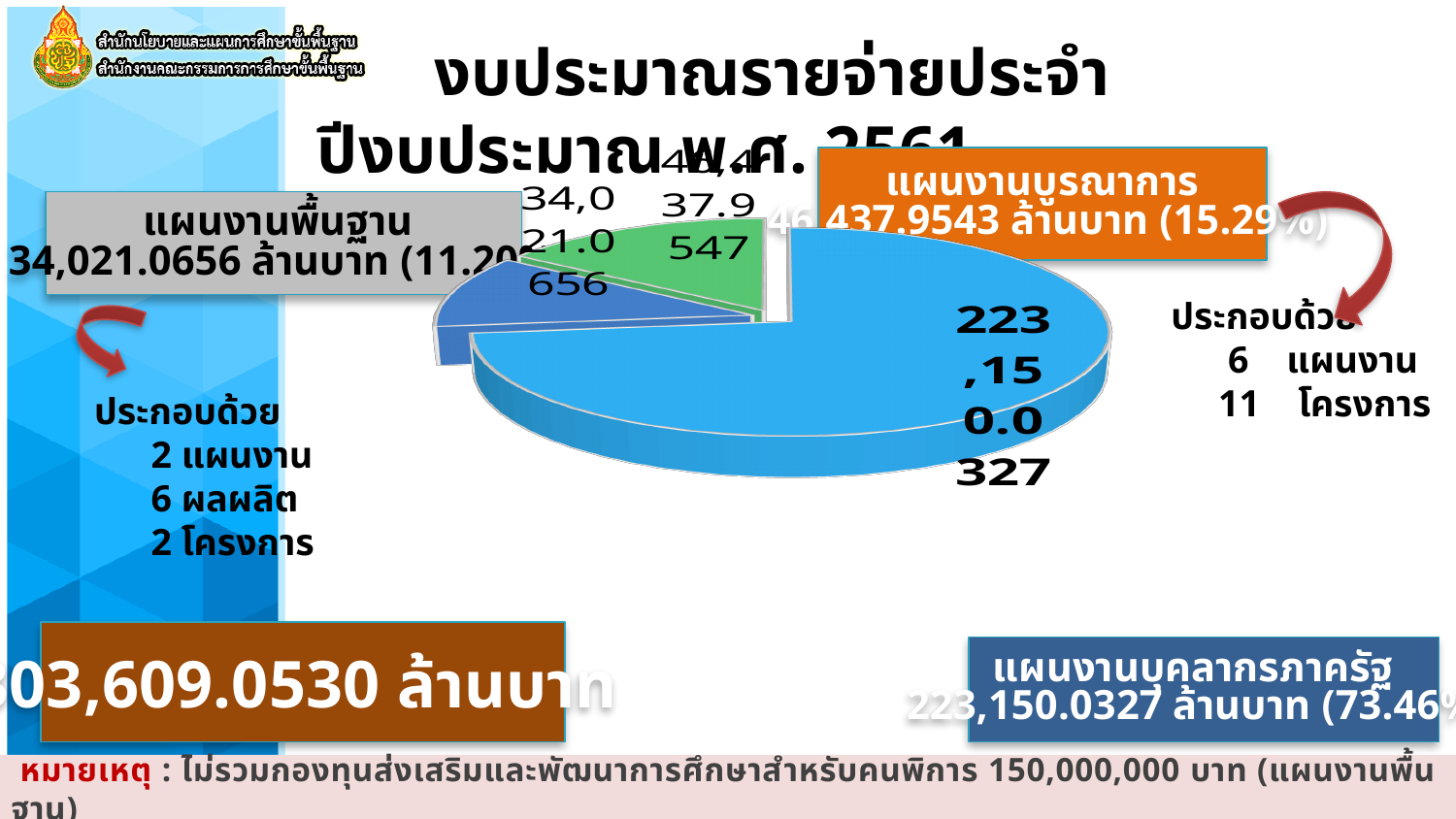
What is the total budget shown for all slices of the pie chart? 303,609.0530 ล้านบาท Which is larger, the budget for แผนงานบูรณาการ or for แผนงานพื้นฐาน? แผนงานบูรณาการ What is the budget value for แผนงานบูรณาการ? 46,437.9543 ล้านบาท What kind of chart is shown on the slide? pie chart Which plan (แผนงาน) has the largest slice of the pie chart? แผนงานบุคลากรภาครัฐ How many slices does the pie chart have? 3 What share of the pie does แผนงานบุคลากรภาครัฐ represent? 73.46% What is the budget value for แผนงานบุคลากรภาครัฐ? 223,150.0327 ล้านบาท What is the difference between the budget for แผนงานบูรณาการ and แผนงานพื้นฐาน? 12,416.8887 ล้านบาท Which plan (แผนงาน) has the smallest slice of the pie chart? แผนงานพื้นฐาน What is the budget value for แผนงานพื้นฐาน? 34,021.0656 ล้านบาท What share of the pie does แผนงานพื้นฐาน represent? 11.20%